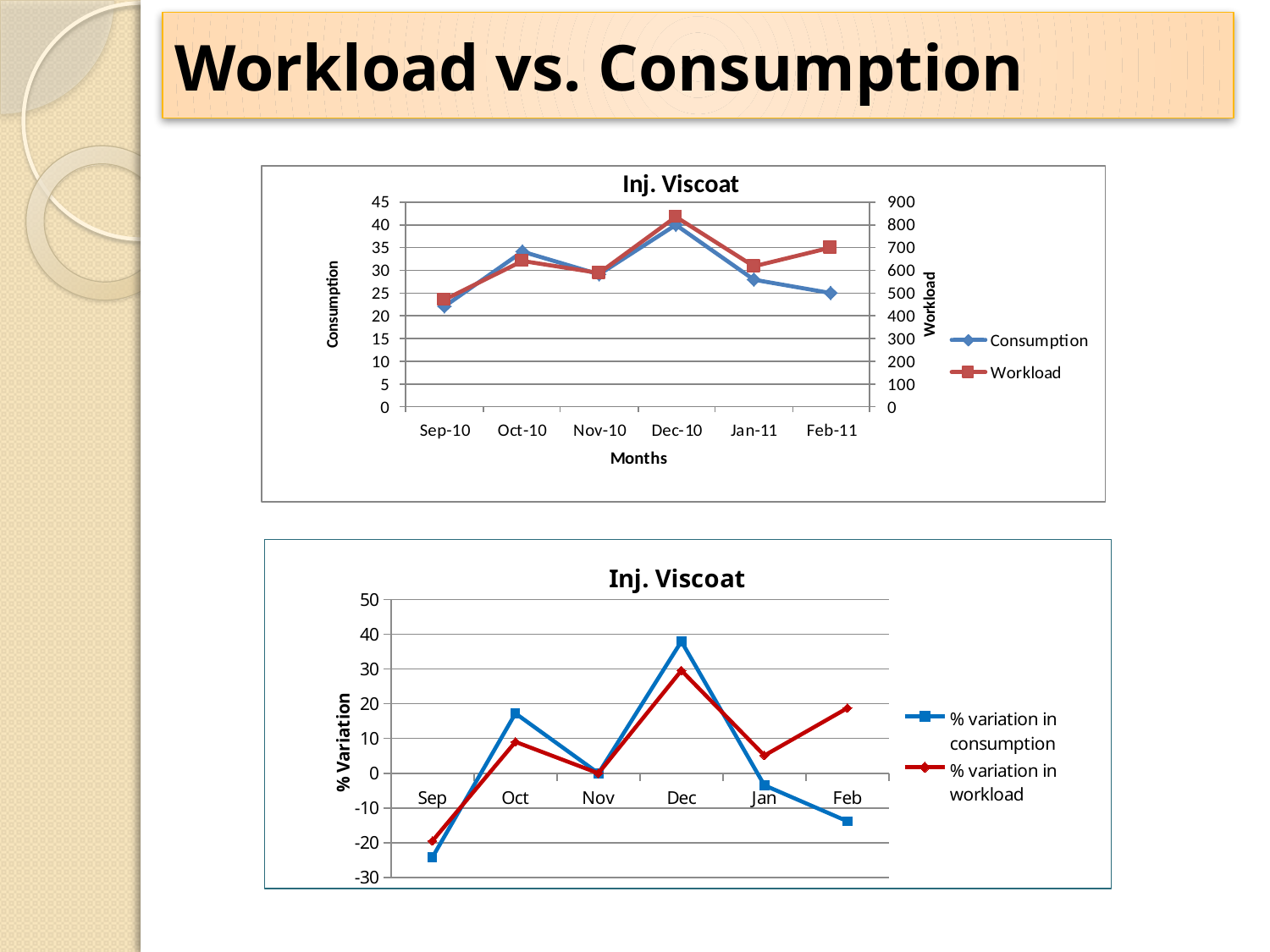
How many months are plotted on the x axis of the top chart? 6 In the top chart, does Consumption rise or fall from Dec-10 to Feb-11? fall In the top chart, which month has the lowest Workload? Sep-10 What kind of chart is the top chart on the slide? line chart In the top chart, is the Workload for Dec-10 greater or less than 800? greater How many series does the legend of the top chart list? 2 In the top chart, which month has the highest Consumption? Dec-10 In the bottom chart, is the % variation in consumption for Sep greater or less than -20? less In the top chart, which is larger: Consumption in Oct-10 or Consumption in Feb-11? Oct-10 In the bottom chart, which month has the highest % variation in consumption? Dec In the top chart, is the Consumption for Sep-10 greater or less than 25? less What is the label of the right-hand vertical axis of the top chart? Workload